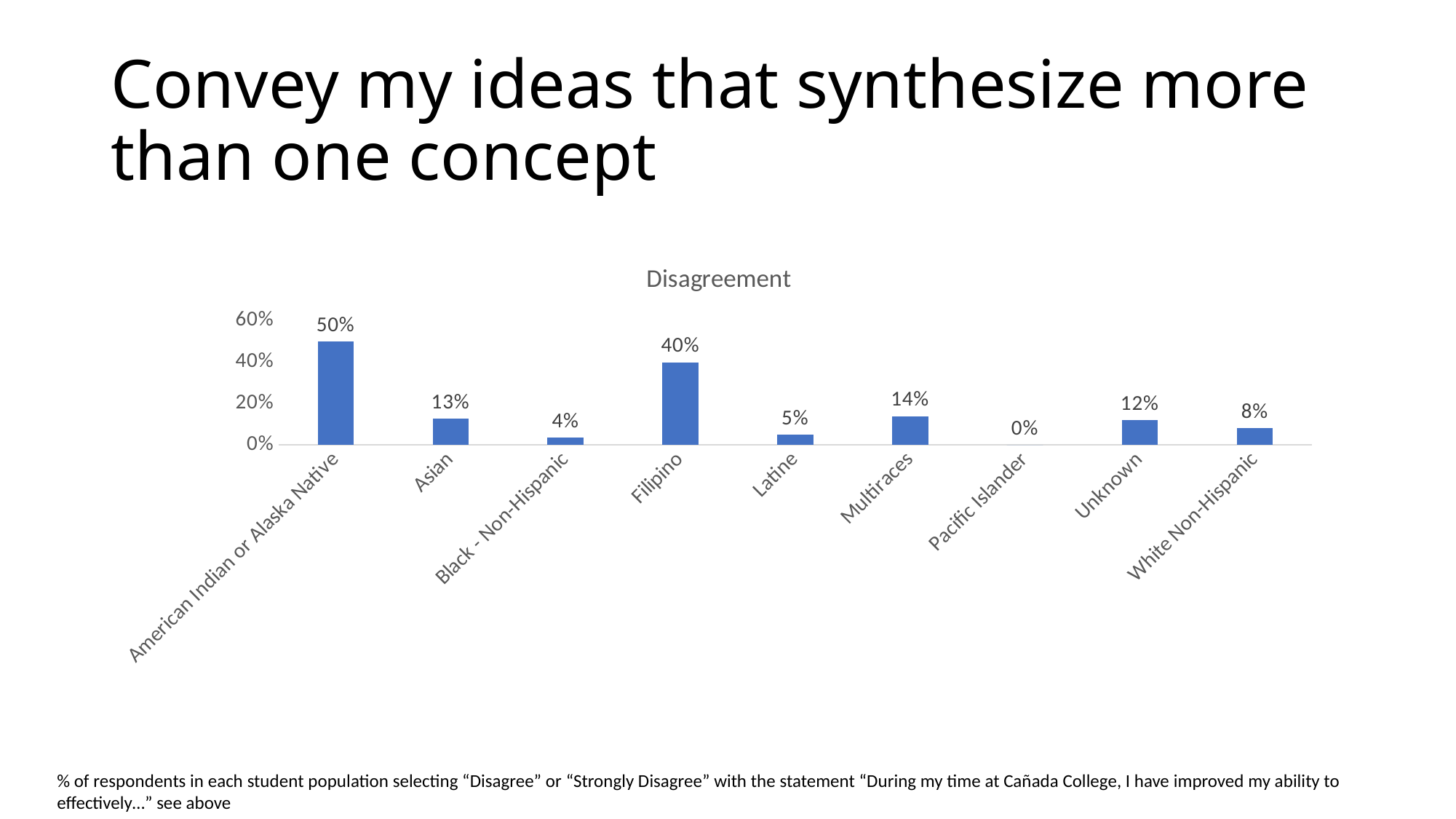
How many categories are shown on the x axis of the chart? 9 Which has a larger Disagreement value, Latine or White Non-Hispanic? White Non-Hispanic What kind of chart is shown on the slide? Bar chart Which category has the lowest Disagreement value? Pacific Islander What is the title of the chart? Disagreement What is the difference between the Disagreement values for American Indian or Alaska Native and Filipino? 10% What is the Disagreement value for Filipino? 40% What is the Disagreement value for Black - Non-Hispanic? 4% What is the Disagreement value for Multiraces? 14% Which has a larger Disagreement value, Unknown or Multiraces? Multiraces What is the difference between the Disagreement values for Asian and White Non-Hispanic? 5% Which category has the highest Disagreement value? American Indian or Alaska Native